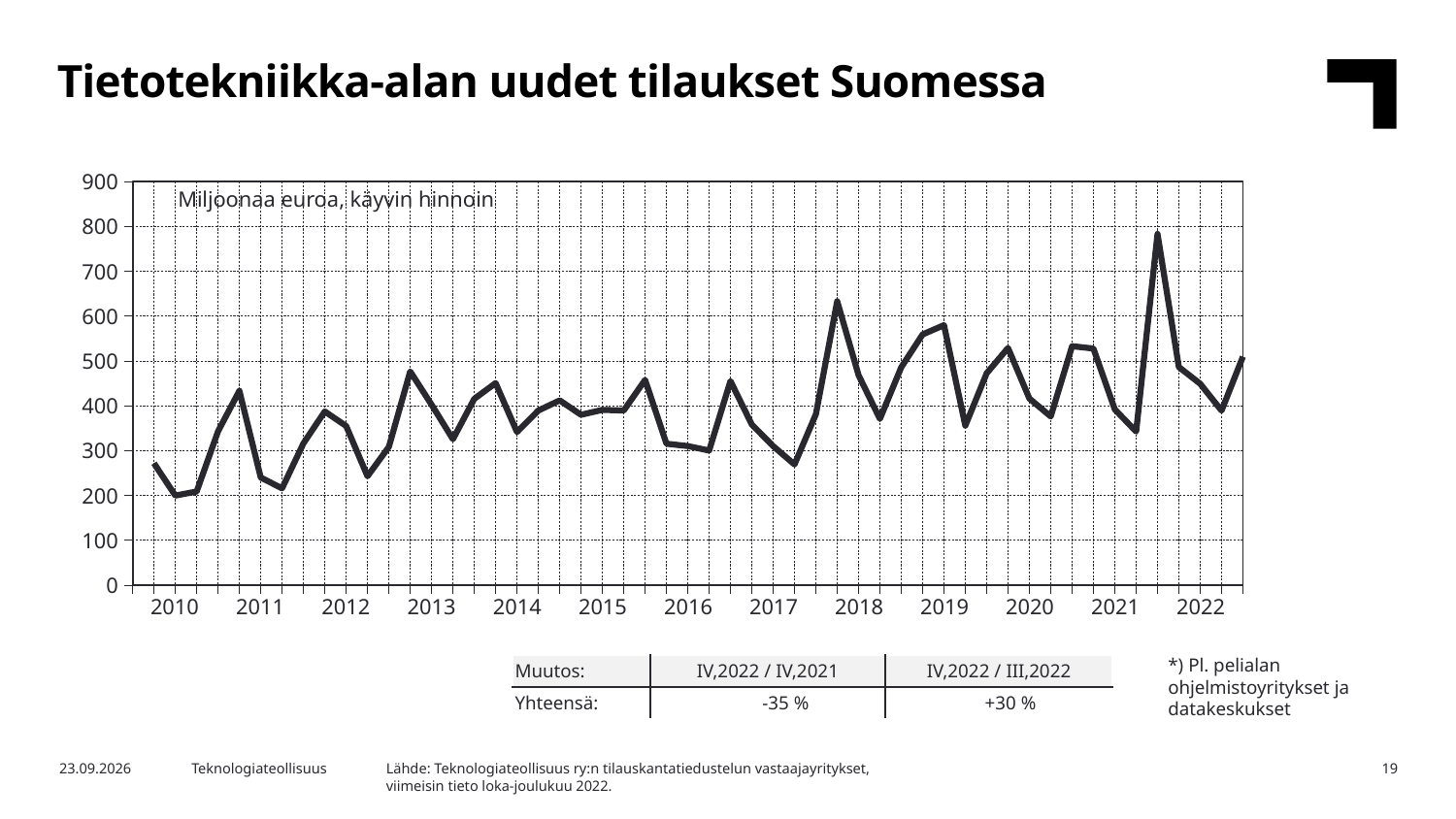
In which year does the line reach its highest peak? 2021 What is the title of the chart on the slide? Tietotekniikka-alan uudet tilaukset Suomessa What is the maximum value shown on the y axis of the chart? 900 What kind of chart is shown on the slide? Line chart Is the last plotted point in 2022 greater or less than 400? greater Is the highest peak of the line in 2021 greater or less than 700? greater How many years are labelled on the x axis of the chart? 13 What is the first year labelled on the x axis? 2010 Is the lowest point of the line in 2010 greater or less than 300? less Which is higher: the peak of the line in 2021 or the peak of the line in 2018? 2021 What is the last year labelled on the x axis? 2022 In what unit are the values on the chart expressed, according to the label inside the plot area? Miljoonaa euroa, käyvin hinnoin